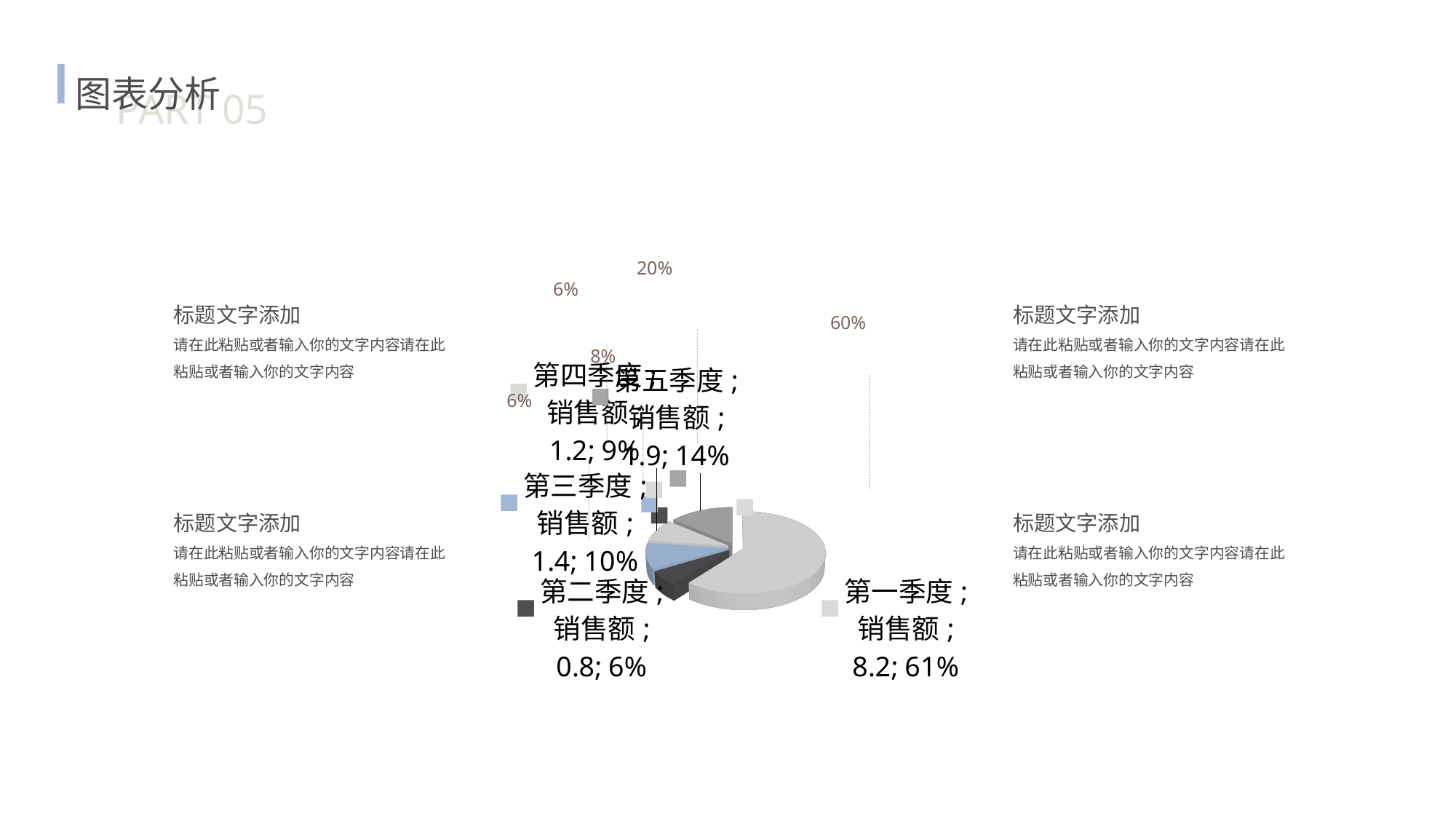
What percentage share does 第一季度 have in the pie chart? 61% How many slices does the pie chart have? 5 Which quarter has the smallest slice in the pie chart? 第二季度 What is the difference between the 销售额 values of 第一季度 and 第五季度? 6.3 What is the percentage share of 第三季度 in the pie chart? 10% What is the 销售额 value for 第一季度 in the pie chart? 8.2 What percentage share does 第五季度 have in the pie chart? 14% What is the 销售额 value for 第三季度 in the pie chart? 1.4 Which quarter has the largest slice in the pie chart? 第一季度 What kind of chart is shown on the slide? Pie chart Which has a larger 销售额 value, 第三季度 or 第四季度? 第三季度 What is the 销售额 value for 第二季度 in the pie chart? 0.8